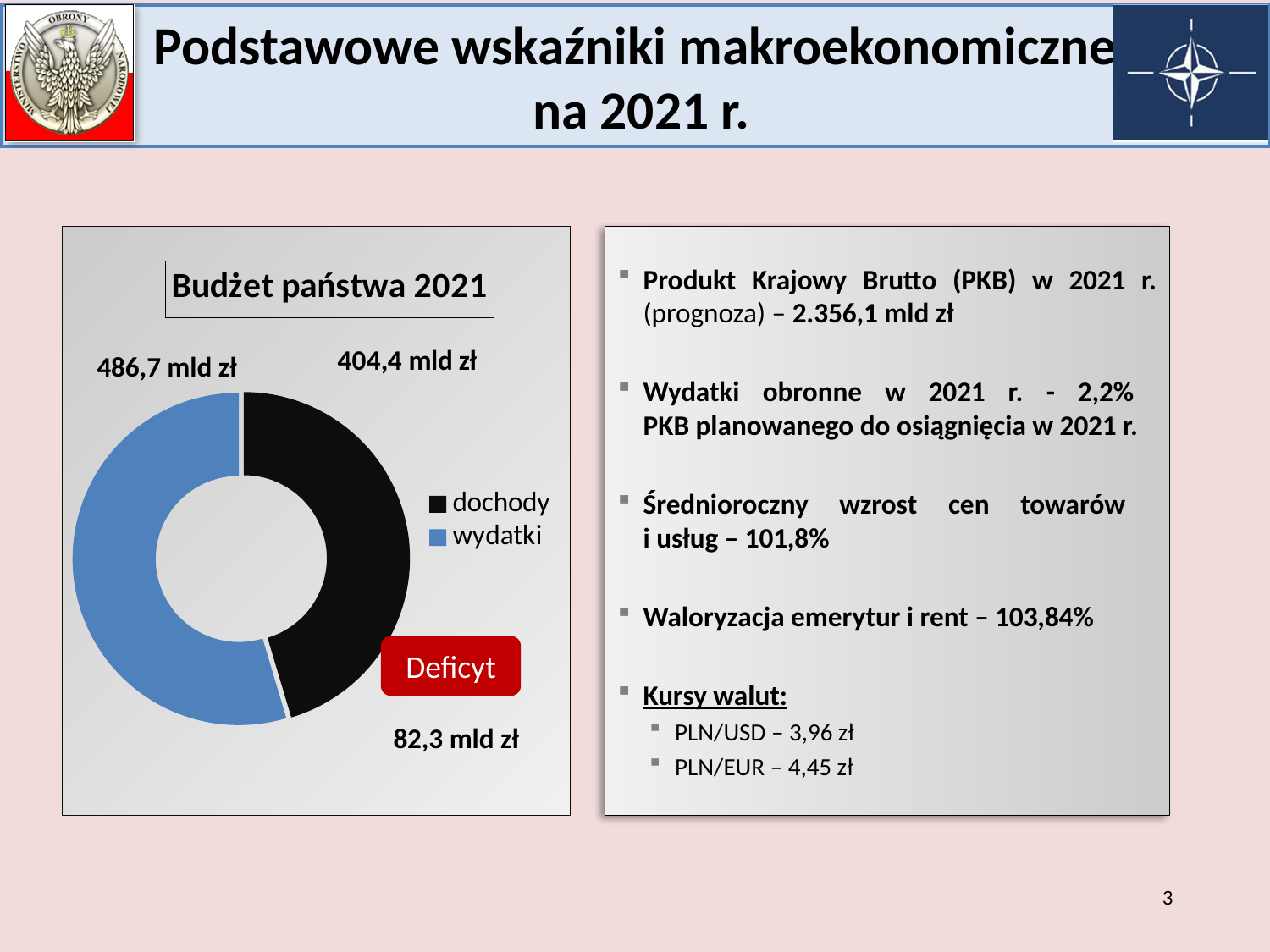
What is the difference between wydatki and dochody? 82,3 mld zł How many slices does the doughnut chart have? 2 What value is shown for the Deficyt? 82,3 mld zł Which category has the smallest slice in the chart? dochody Which category has the larger slice, dochody or wydatki? wydatki Which colour represents dochody in the chart? black How many entries does the chart legend list? 2 What is the value shown for dochody? 404,4 mld zł What is the title of the chart? Budżet państwa 2021 What kind of chart is shown on the slide? doughnut chart What is the value shown for wydatki? 486,7 mld zł